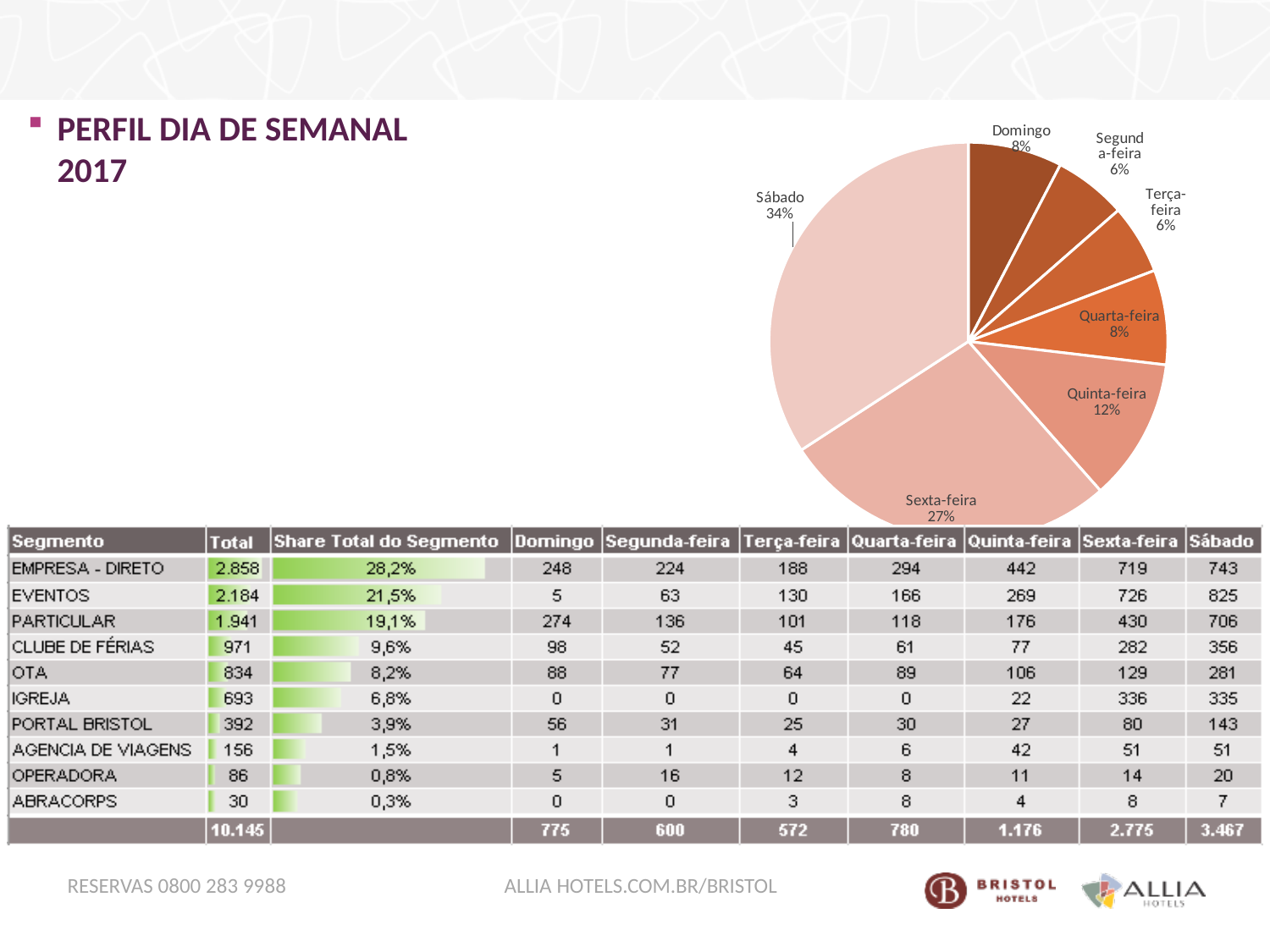
What share of the pie does Sábado represent? 34% What share of the pie does Sexta-feira represent? 27% Which slice is larger in the pie chart, Quinta-feira or Quarta-feira? Quinta-feira Which slice is larger in the pie chart, Sexta-feira or Quinta-feira? Sexta-feira What is the value shown for Quinta-feira in the pie chart? 12% What is the value shown for Domingo in the pie chart? 8% What is the title of the slide containing the pie chart? PERFIL DIA DE SEMANAL 2017 What is the difference in percentage points between the Sábado and Sexta-feira slices? 7 Which day has the largest slice of the pie chart? Sábado How many slices does the pie chart have? 7 What kind of chart is shown on the slide? Pie chart What is the difference in percentage points between the Quinta-feira and Domingo slices? 4